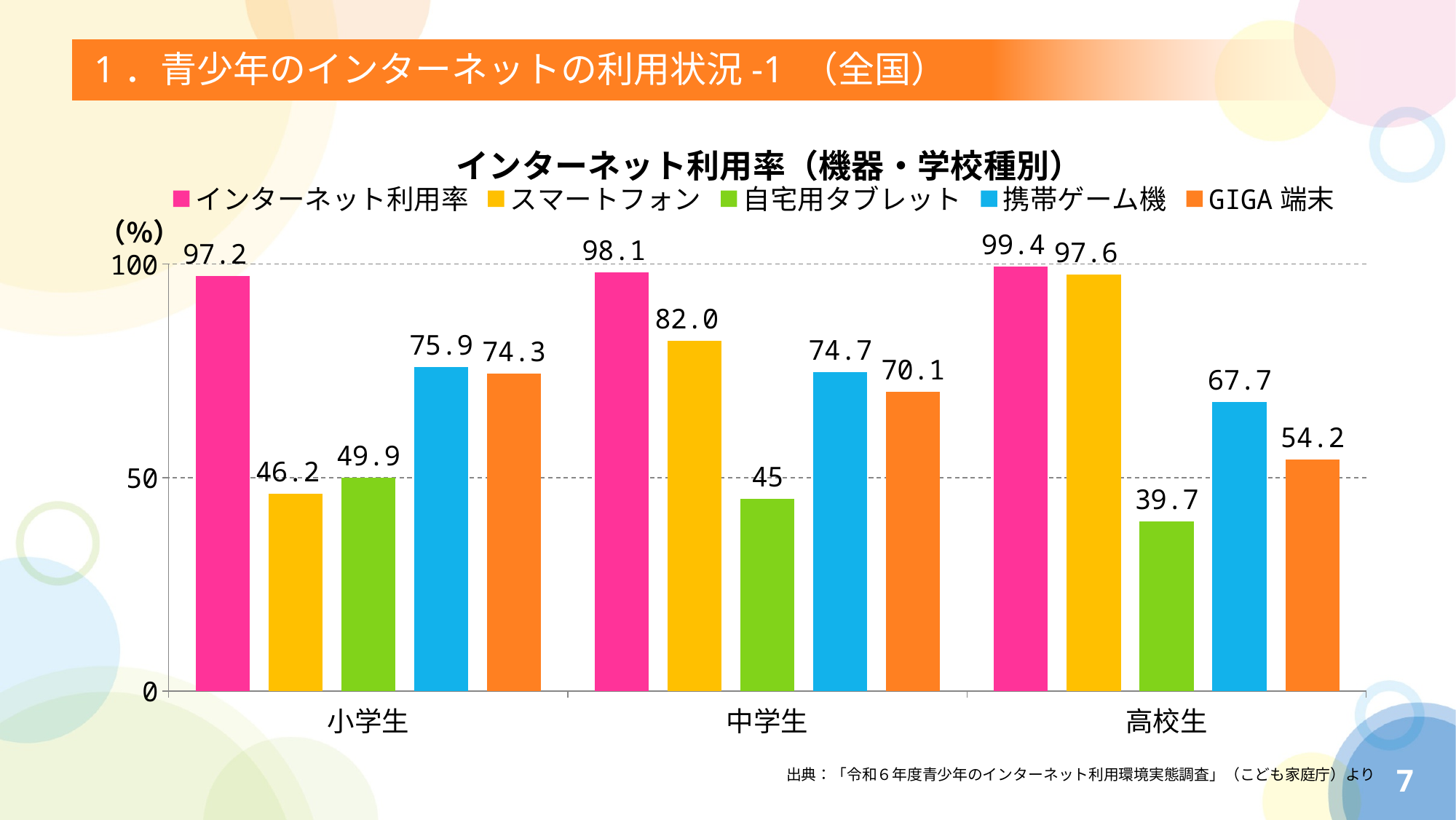
Which is larger for 中学生: 携帯ゲーム機 or GIGA 端末? 携帯ゲーム機 What is the 自宅用タブレット value for 中学生? 45 What is the スマートフォン value for 小学生? 46.2 Which school category has the highest インターネット利用率? 高校生 What is the difference between the スマートフォン values for 高校生 and 小学生? 51.4 What kind of chart is shown? bar chart Does the 携帯ゲーム機 value rise or fall from 中学生 to 高校生? fall How many school categories are shown on the x axis? 3 Is the 自宅用タブレット value for 高校生 greater or less than 50? less What is the GIGA 端末 value for 高校生? 54.2 Which school category has the lowest 自宅用タブレット value? 高校生 How many series does the legend list? 5